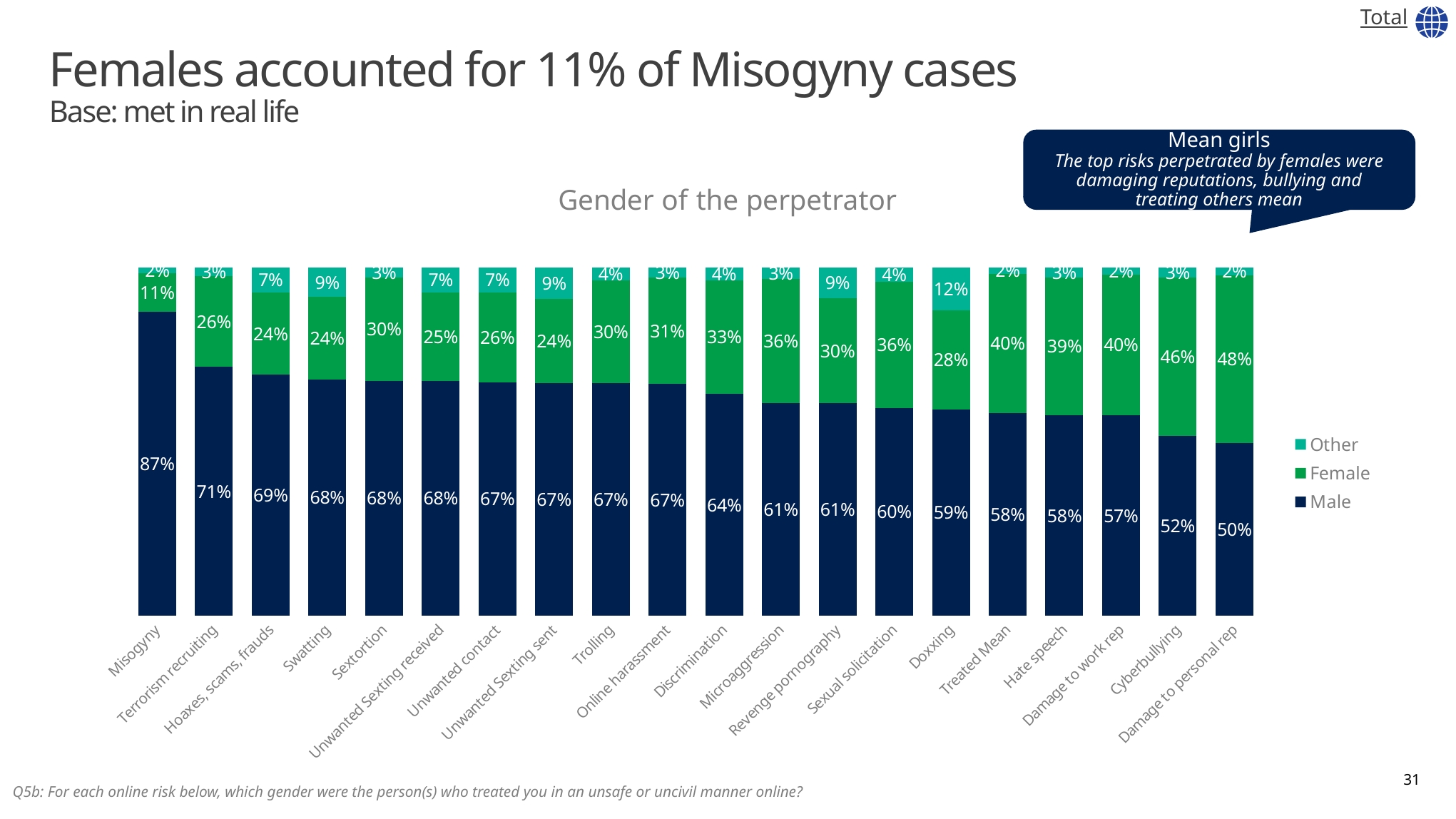
How many series does the legend list? 3 How many categories are shown along the x axis? 20 Which category has the highest Male value? Misogyny Which category has the lowest Male value? Damage to personal rep What kind of chart is shown on the slide? Stacked bar chart What is the Male value for Misogyny? 87% Which category has the highest Other value? Doxxing What is the difference between the Male value for Misogyny and the Male value for Damage to personal rep? 37% Which is larger, the Female value for Cyberbullying or the Female value for Hate speech? Cyberbullying What is the Female value for Damage to personal rep? 48% What is the title of the chart? Gender of the perpetrator What is the Other value for Doxxing? 12%